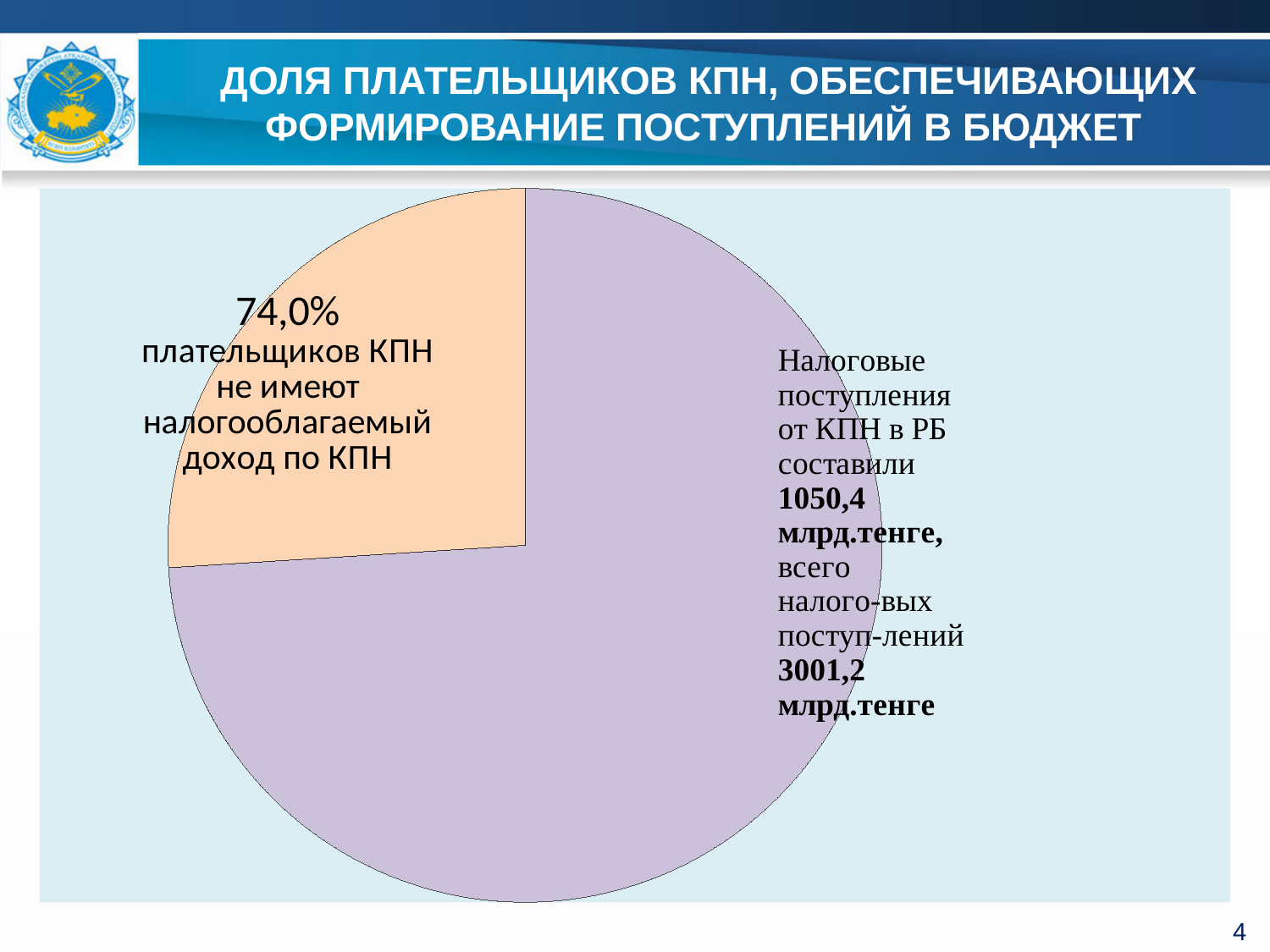
According to the text on the chart, what share of КПН payers do not have taxable income for КПН? 74,0% What percentage value is printed on the pie chart? 74,0% How many slices does the pie chart have? 2 Which slice of the pie chart is larger, the purple one or the orange one? the purple one Is the orange slice of the pie chart greater or less than half of the pie? less According to the text on the chart, how much did tax receipts from КПН to the republican budget amount to? 1050,4 млрд.тенге Which colour slice is the smallest in the pie chart? orange What kind of chart is shown on the slide? pie chart Is the purple slice of the pie chart greater or less than half of the pie? greater Which colour slice is the largest in the pie chart? purple What is the title of the slide containing the pie chart? ДОЛЯ ПЛАТЕЛЬЩИКОВ КПН, ОБЕСПЕЧИВАЮЩИХ ФОРМИРОВАНИЕ ПОСТУПЛЕНИЙ В БЮДЖЕТ